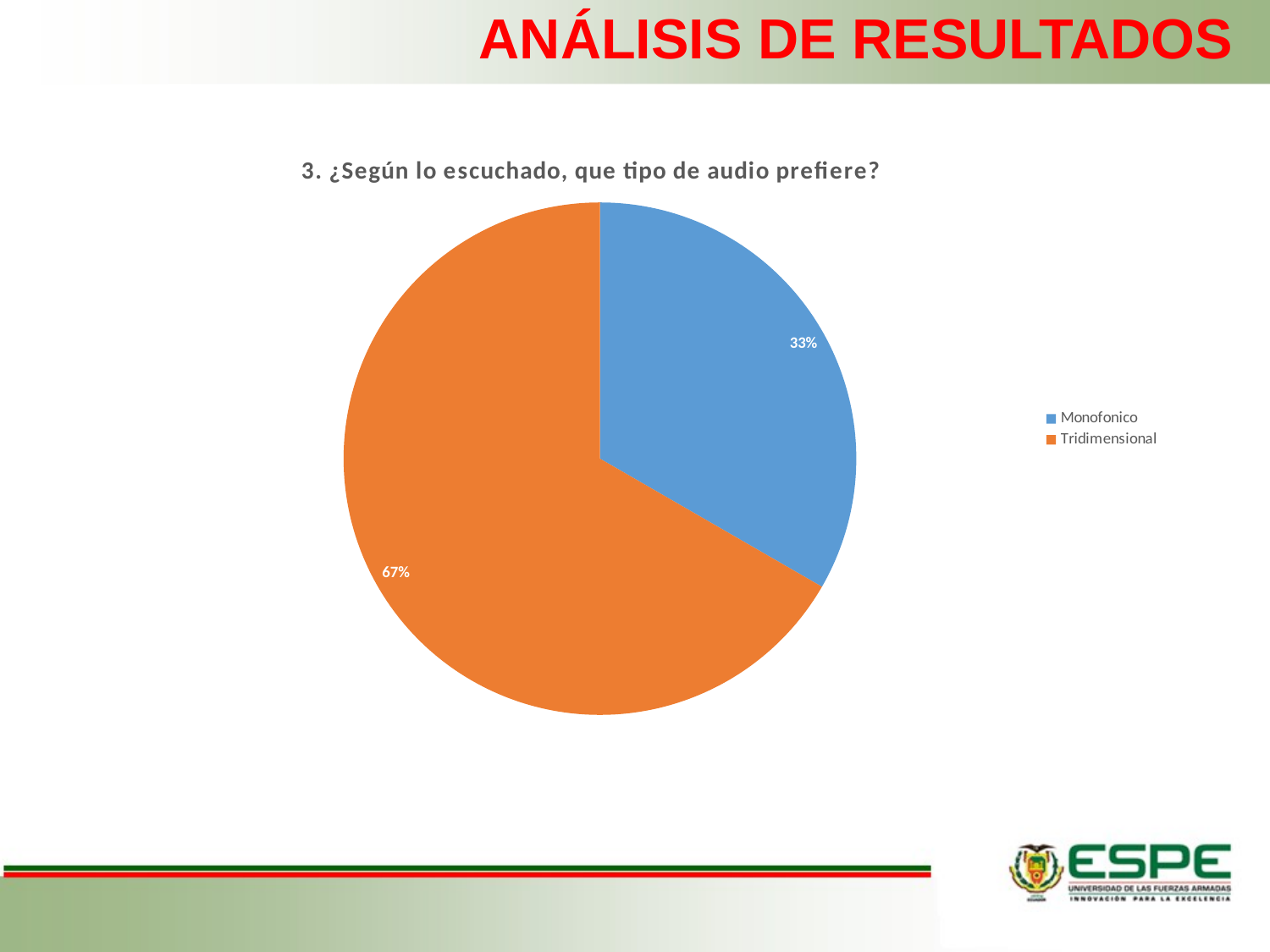
What is the title of the chart? 3. ¿Según lo escuchado, que tipo de audio prefiere? Which is larger, the slice for Monofonico or the slice for Tridimensional? Tridimensional How many categories does the pie chart show? 2 Which category has the largest slice of the pie? Tridimensional What share of the pie does Tridimensional represent? 67% What colour is the Tridimensional slice? orange What share of the pie does Monofonico represent? 33% How many entries does the legend list? 2 What type of chart is shown on the slide? pie chart What is the difference in percentage points between Tridimensional and Monofonico? 34 Which category has the smallest slice of the pie? Monofonico